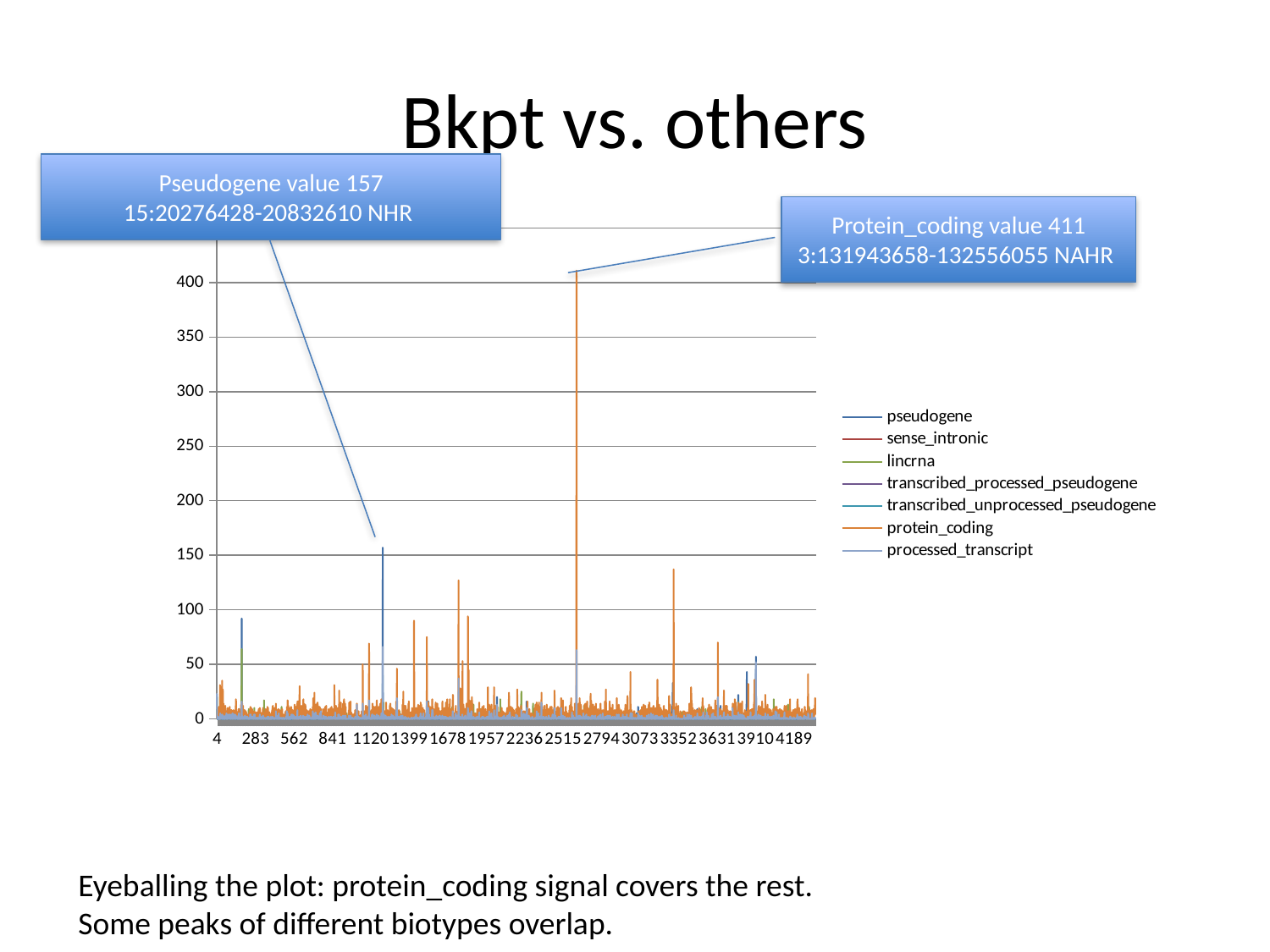
Is the labelled pseudogene peak greater or less than 150? greater Is the protein_coding peak near x label 3352 greater or less than 150? less Which is larger, the labelled protein_coding peak or the labelled pseudogene peak? protein_coding peak Is the protein_coding peak near x label 3352 greater or less than 100? greater How many series does the legend list? 7 According to the callout, what is the highlighted pseudogene peak value? 157 What is the title of the slide containing the chart? Bkpt vs. others What kind of chart is shown on the slide? line chart Which series is listed last in the legend? processed_transcript What is the difference between the labelled protein_coding peak (411) and the labelled pseudogene peak (157)? 254 Which series reaches the highest value on the chart? protein_coding According to the callout, what is the highlighted protein_coding peak value? 411